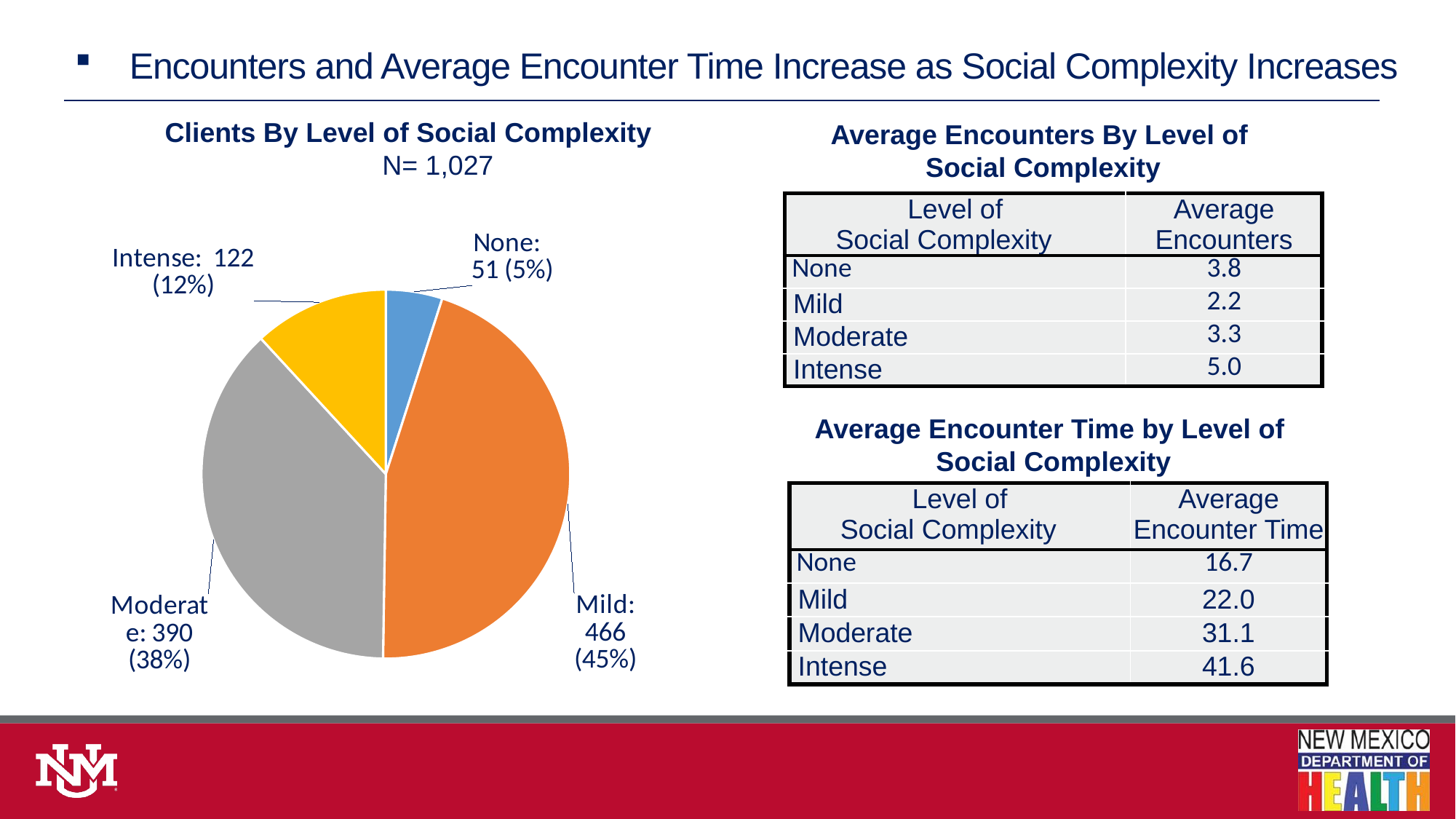
How many clients are in the None level of social complexity? 51 How many clients are in the Moderate level of social complexity? 390 Which level of social complexity has the smallest share of clients? None What share of clients are in the Moderate level of social complexity? 38% How many levels of social complexity are shown in the pie chart? 4 What is the difference in the number of clients between the Mild and Moderate levels? 76 What kind of chart is "Clients By Level of Social Complexity"? pie chart What share of clients are in the Intense level of social complexity? 12% Which level of social complexity has the largest share of clients? Mild How many clients are in the Mild level of social complexity? 466 How many clients are in the Intense level of social complexity? 122 Which has more clients, the Intense level or the None level? Intense